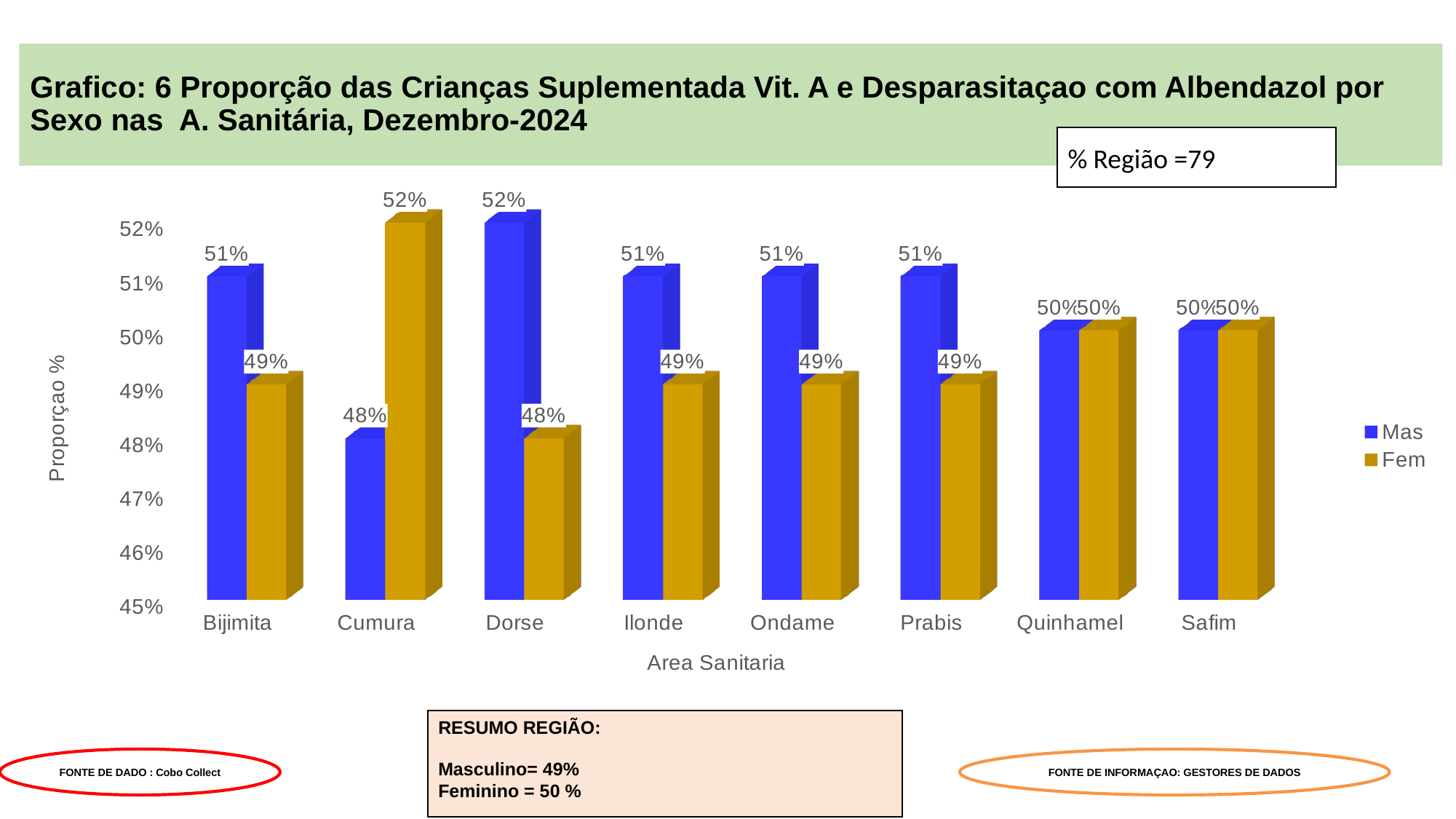
What is the Fem value for Ondame? 49% What kind of chart is shown on the slide? Bar chart How many series does the legend list? 2 Which area has the lowest Fem value? Dorse What is the Mas value for Cumura? 48% What is the label of the y axis? Proporçao % Which area has the highest Mas value? Dorse How many areas (categories) are shown on the x axis? 8 What is the Fem value for Cumura? 52% For Bijimita, which is larger, the Mas value or the Fem value? Mas What is the Mas value for Dorse? 52% What is the difference between the Fem and Mas values for Cumura? 4%